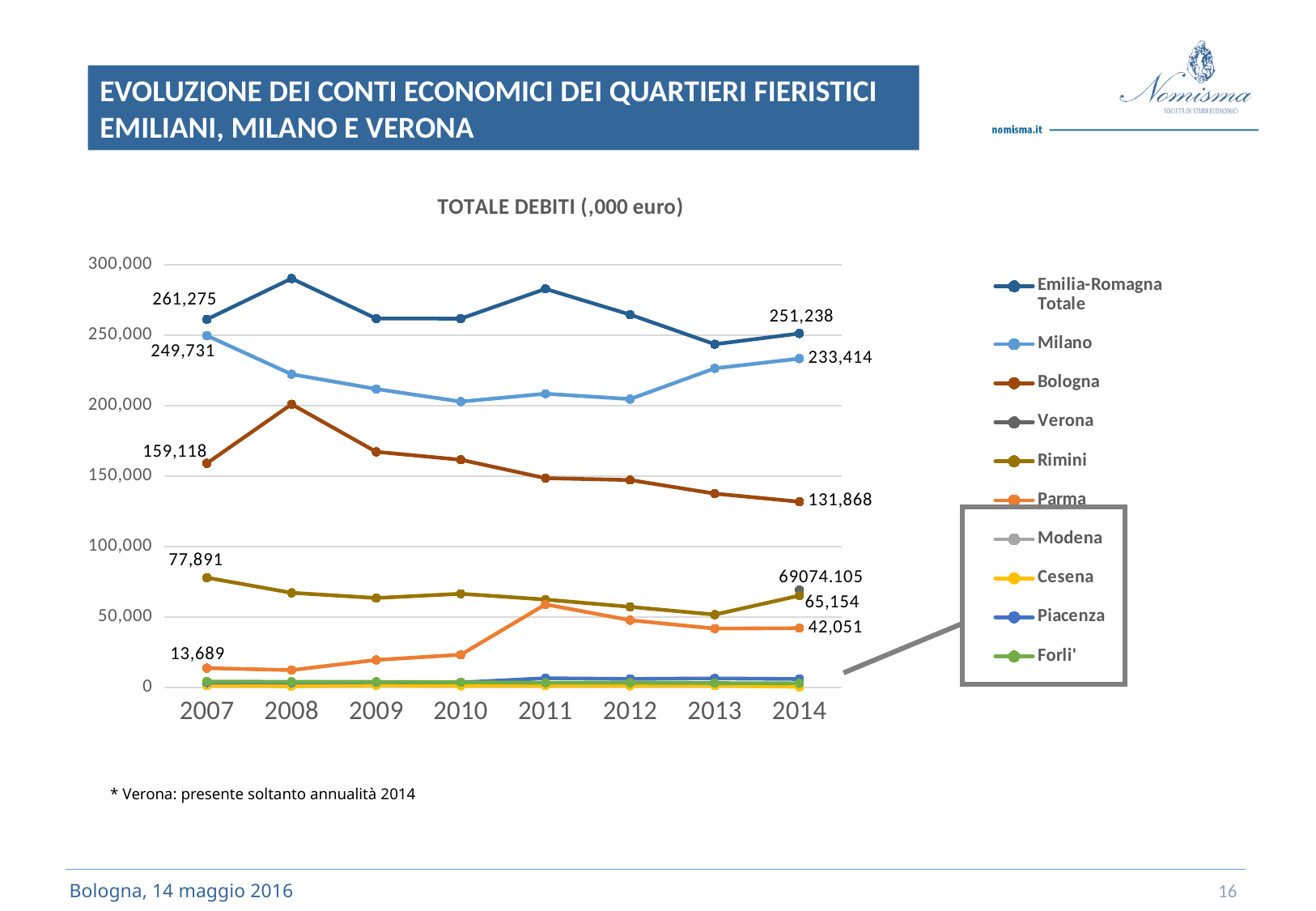
How many years are plotted along the x axis? 8 How many series does the legend list? 10 By how much did the value for Bologna fall between 2007 and 2014? 27,250 What is the difference between the Parma value in 2014 and in 2007? 28,362 What is the value for Emilia-Romagna Totale in 2007? 261,275 In which year does the Emilia-Romagna Totale line reach its highest value? 2008 What kind of chart is shown on the slide? line chart What is the value for Milano in 2014? 233,414 What is the difference between the Emilia-Romagna Totale value in 2007 and in 2014? 10,037 In 2014, which is larger: the value for Rimini or the value for Parma? Rimini What is the value for Bologna in 2007? 159,118 Is the value for Milano in 2010 greater or less than 250,000? less